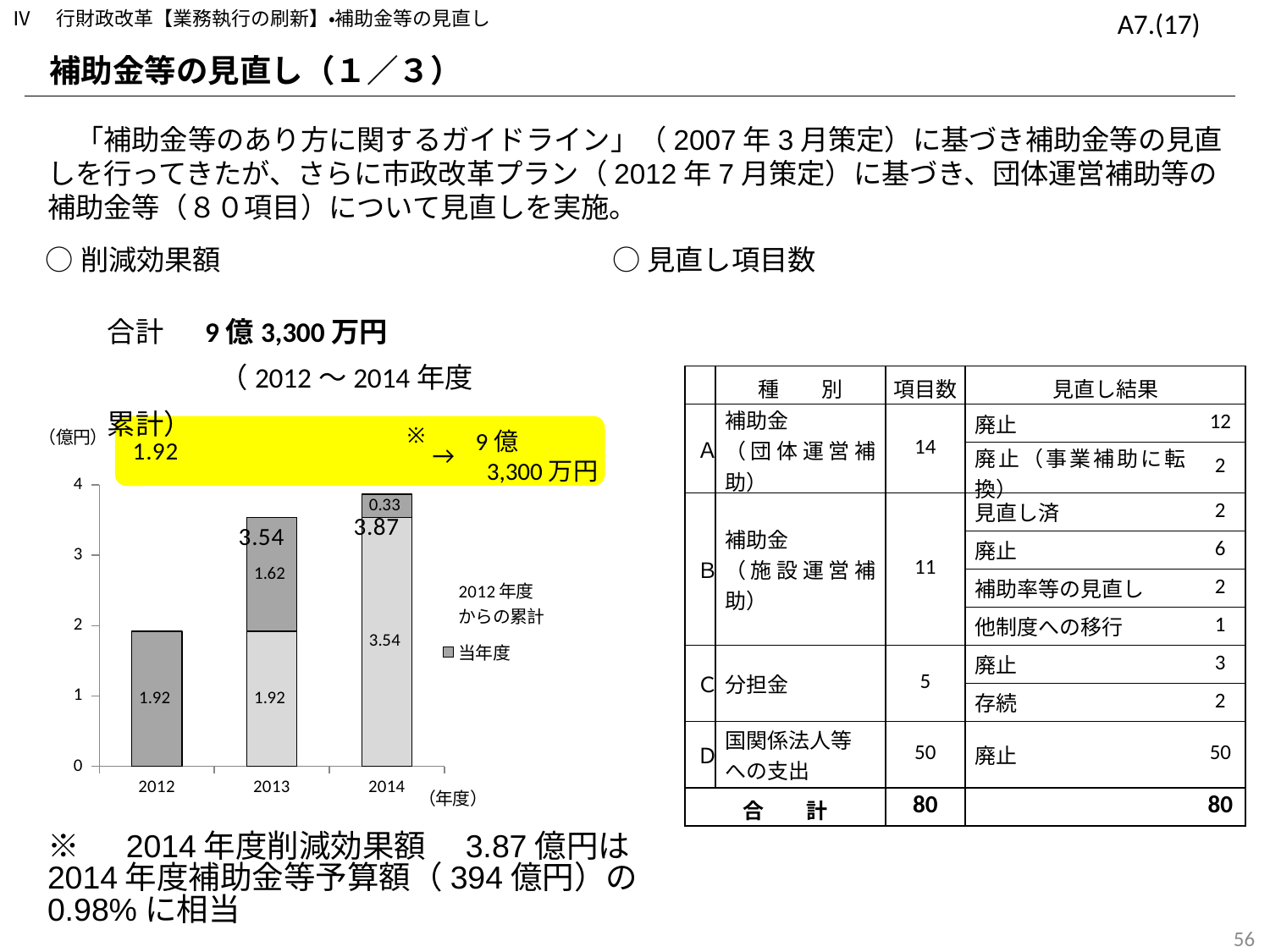
What is the difference between the total for 2014 and the total for 2013? 0.33 What is the total of the stacked bar for 2014? 3.87 How many years (categories) are shown on the x axis of the chart? 3 Which year has the lowest total bar? 2012 How many series does the chart legend list? 2 Is the total for 2012 greater or less than 2? less What type of chart is shown on the slide? bar chart Do the total bar values rise or fall from 2012 to 2014? rise What is the value of the 当年度 segment for 2013? 1.62 What is the total of the stacked bar for 2013? 3.54 What is the value of the 2012年度からの累計 segment for 2014? 3.54 What is the value of the 当年度 segment for 2014? 0.33